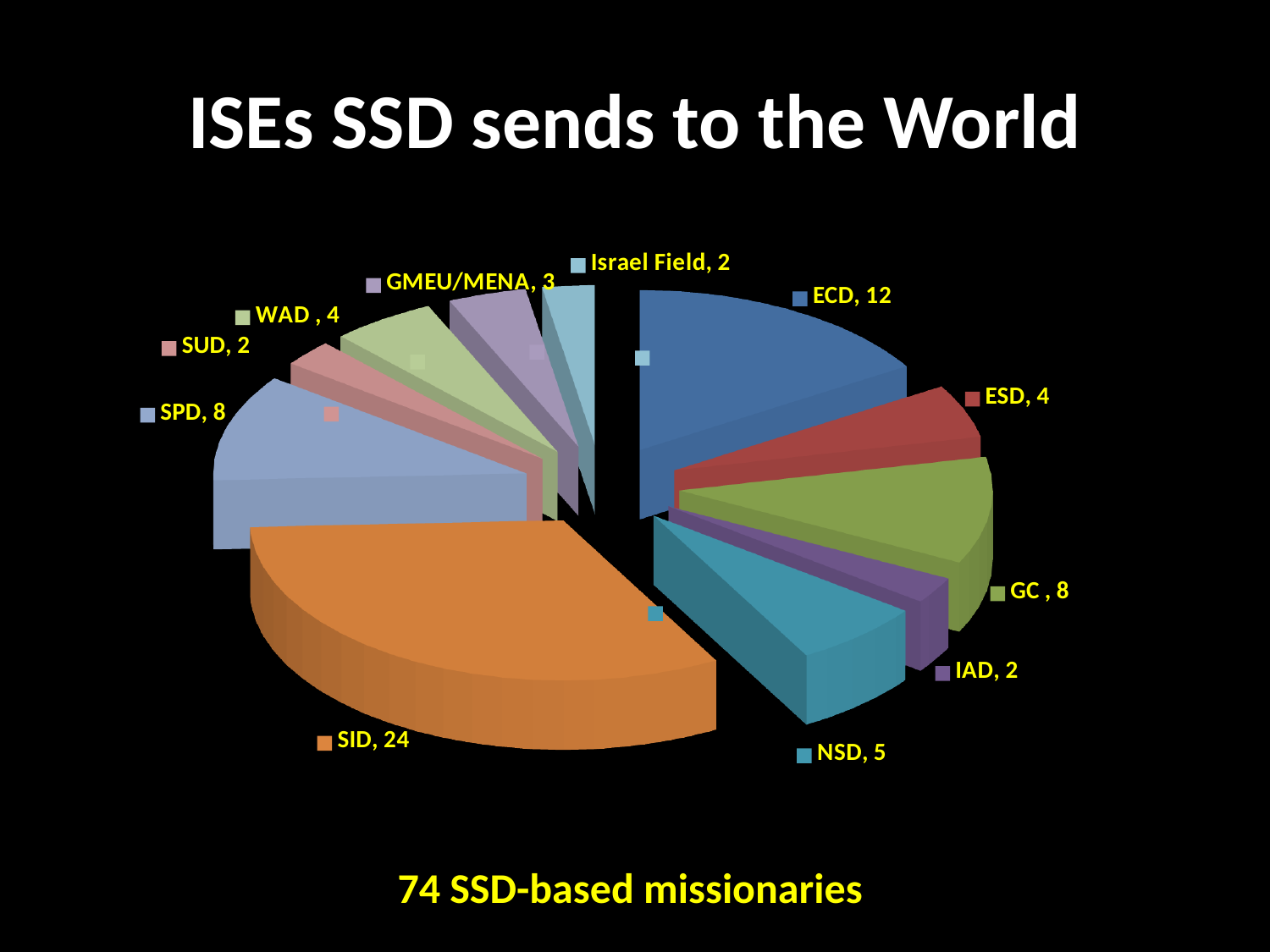
What is the title of the chart? ISEs SSD sends to the World What is the total number of SSD-based missionaries stated on the slide? 74 How many categories are shown in the pie chart? 11 What is the value for NSD? 5 What is the value for ECD? 12 How many ISEs does SSD send to SID? 24 What is the value for GMEU/MENA? 3 Which is larger, the value for GC or the value for ESD? GC Which category has the largest slice of the pie? SID What is the difference between the values for SID and ECD? 12 What type of chart is shown on the slide? Pie chart